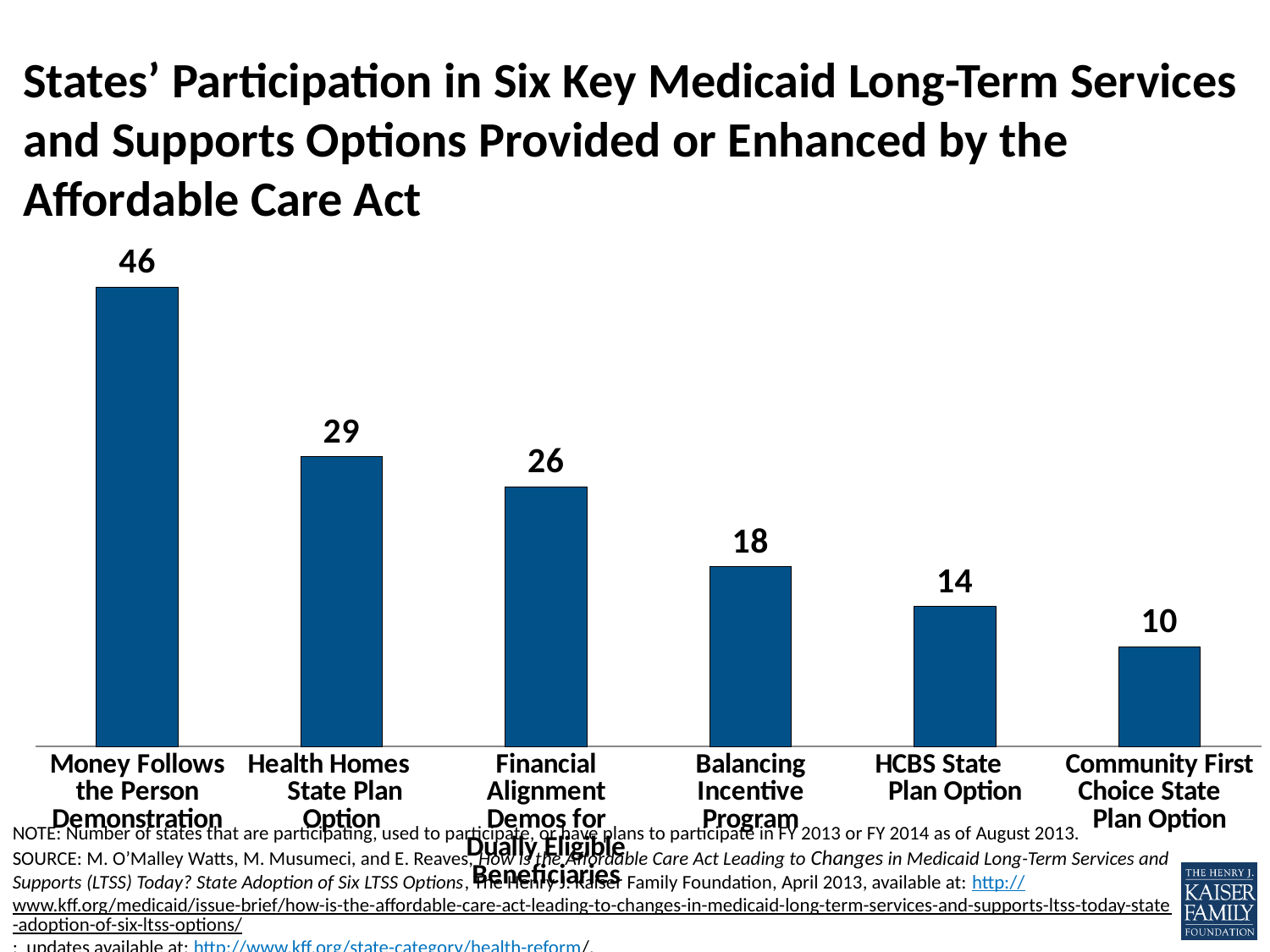
Which is larger: the value for Financial Alignment Demos for Dually Eligible Beneficiaries or the value for the Balancing Incentive Program? Financial Alignment Demos for Dually Eligible Beneficiaries How many options (categories) are shown in the chart? 6 Which option has the lowest number of participating states? Community First Choice State Plan Option What kind of chart is shown on the slide? Bar chart What is the difference between the values for the Money Follows the Person Demonstration and the Health Homes State Plan Option? 17 What is the value shown for the Balancing Incentive Program? 18 What is the difference between the values for the HCBS State Plan Option and the Community First Choice State Plan Option? 4 How many states participate in the Money Follows the Person Demonstration? 46 What is the value shown for the Health Homes State Plan Option? 29 Do the values rise or fall moving from left to right across the chart? Fall Which option has the highest number of participating states? Money Follows the Person Demonstration What is the value shown for the Community First Choice State Plan Option? 10